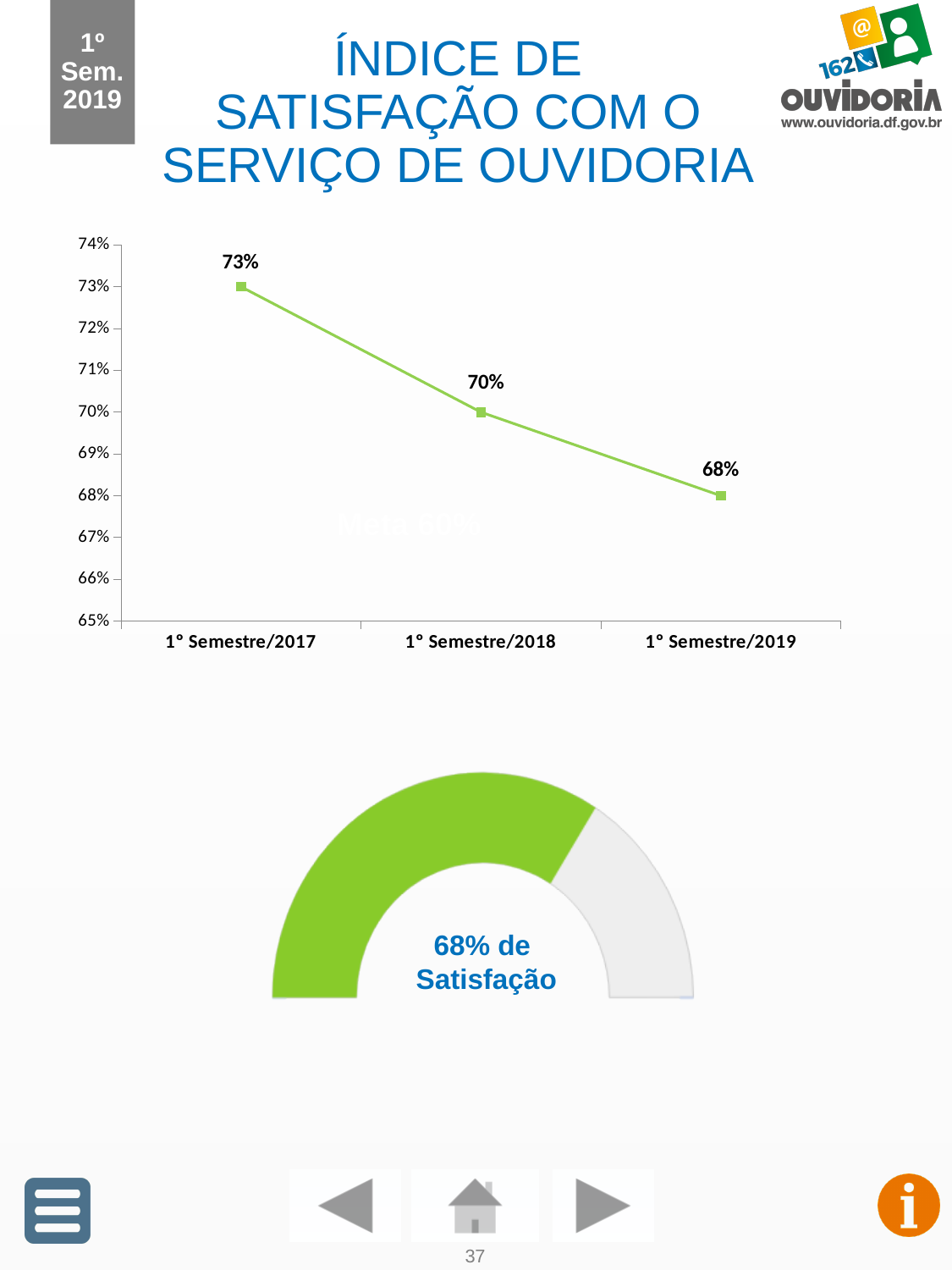
In the line chart at the top of the slide, what is the difference between the values for 1° Semestre/2017 and 1° Semestre/2019? 5% What satisfaction percentage is shown in the gauge chart at the bottom of the slide? 68% In the line chart at the top of the slide, which period has the lowest value? 1° Semestre/2019 In the line chart at the top of the slide, what is the value for 1° Semestre/2017? 73% What kind of chart is shown at the top of the slide? Line chart In the line chart at the top of the slide, how many data points are plotted? 3 In the line chart at the top of the slide, what is the difference between the values for 1° Semestre/2018 and 1° Semestre/2019? 2% In the line chart at the top of the slide, what is the value for 1° Semestre/2018? 70% In the line chart at the top of the slide, do the values rise or fall from 1° Semestre/2017 to 1° Semestre/2019? Fall In the line chart at the top of the slide, which is larger: the value for 1° Semestre/2017 or 1° Semestre/2018? 1° Semestre/2017 In the line chart at the top of the slide, which period has the highest value? 1° Semestre/2017 In the line chart at the top of the slide, what is the value for 1° Semestre/2019? 68%